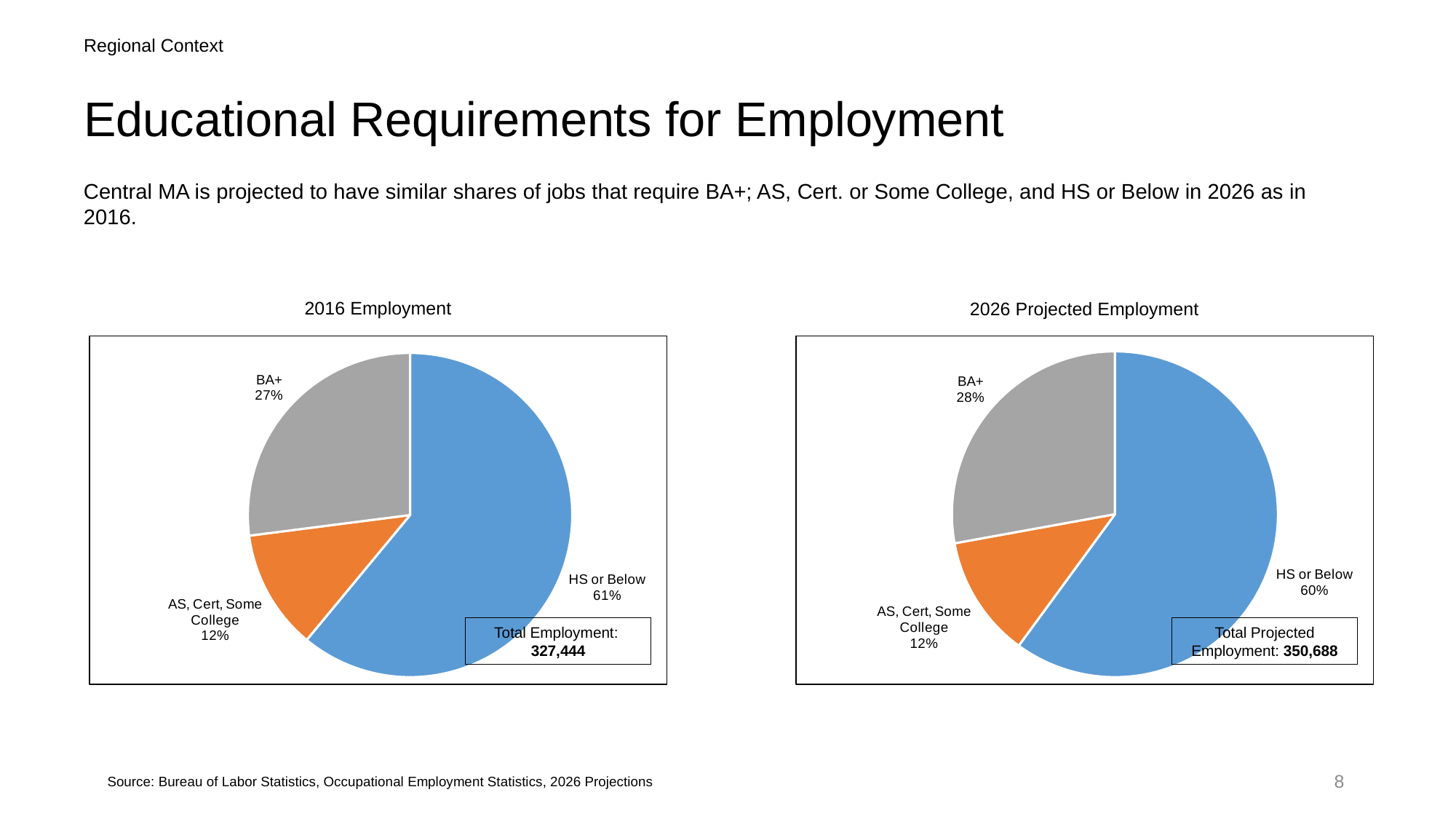
In the 2026 Projected Employment chart, what is the difference between the HS or Below share and the BA+ share? 32 percentage points In the 2016 Employment chart, what share of jobs require AS, Cert, Some College? 12% In the 2016 Employment chart, which category has the smallest share? AS, Cert, Some College What is the total employment shown in the 2016 Employment chart? 327,444 In the 2026 Projected Employment chart, which is larger: the BA+ share or the AS, Cert, Some College share? BA+ What type of chart is used for 2026 Projected Employment? Pie chart What is the total projected employment shown in the 2026 Projected Employment chart? 350,688 In the 2016 Employment chart, what share of jobs require HS or Below? 61% How many slices does the 2016 Employment pie chart have? 3 In the 2016 Employment chart, what is the difference between the HS or Below share and the BA+ share? 34 percentage points In the 2026 Projected Employment chart, what share of jobs require BA+? 28% In the 2026 Projected Employment chart, which category has the largest share? HS or Below